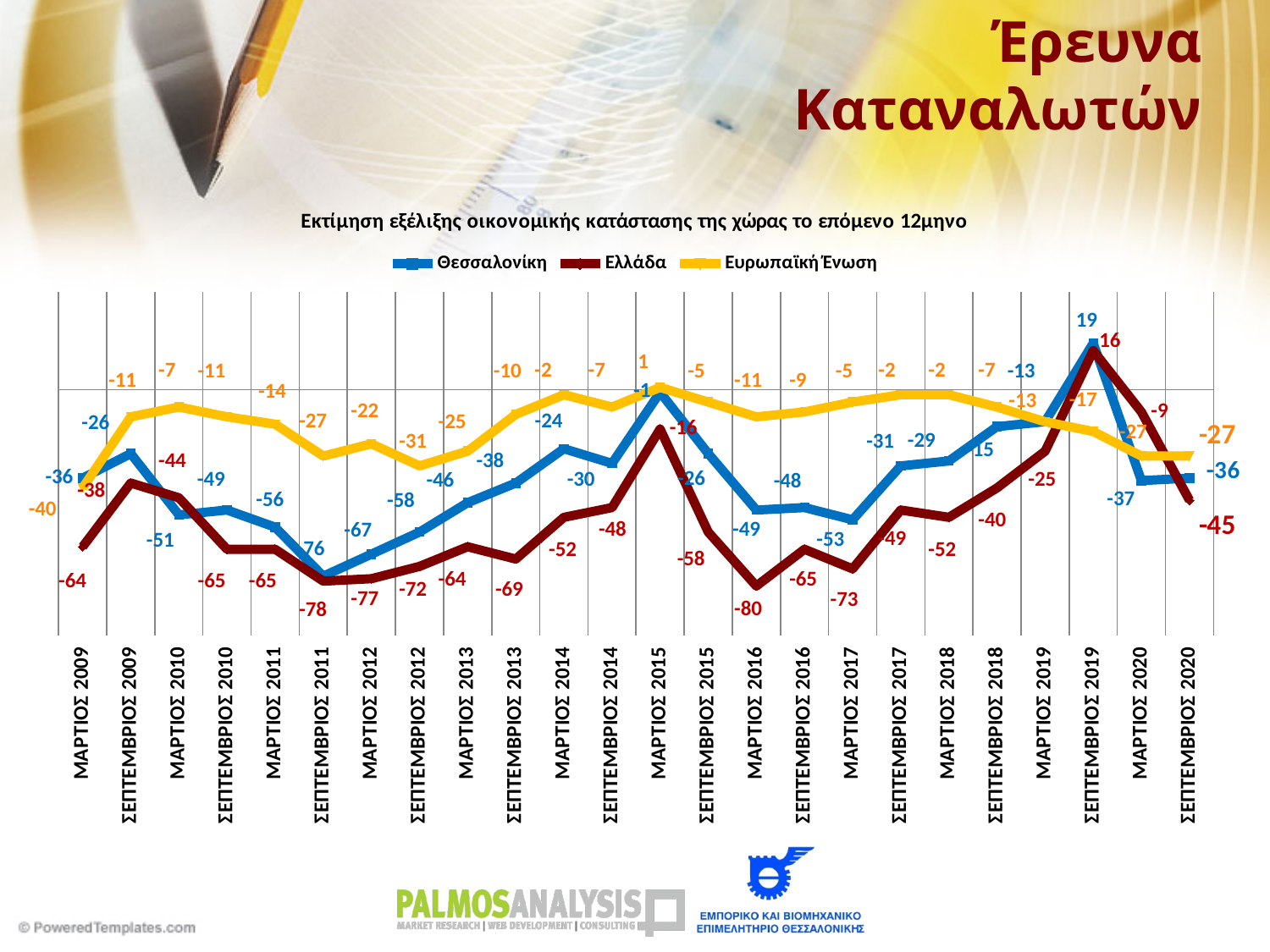
What is the value for Ελλάδα in ΣΕΠΤΕΜΒΡΙΟΣ 2020? -45 At which time point does the Θεσσαλονίκη series reach its highest value? ΣΕΠΤΕΜΒΡΙΟΣ 2019 What is the value for Ελλάδα in ΜΑΡΤΙΟΣ 2016? -80 At which time point does the Ελλάδα series reach its lowest value? ΜΑΡΤΙΟΣ 2016 What kind of chart is shown on the slide? Line chart How many time points are plotted along the x axis? 24 How many series does the legend list? 3 What is the difference between the Θεσσαλονίκη and Ελλάδα values in ΣΕΠΤΕΜΒΡΙΟΣ 2020? 9 In ΜΑΡΤΙΟΣ 2009, which series has the higher value, Θεσσαλονίκη or Ελλάδα? Θεσσαλονίκη What is the value for Ευρωπαϊκή Ένωση in ΜΑΡΤΙΟΣ 2009? -40 What is the value for Θεσσαλονίκη in ΣΕΠΤΕΜΒΡΙΟΣ 2019? 19 Which colour represents the Ευρωπαϊκή Ένωση series in the legend? Yellow